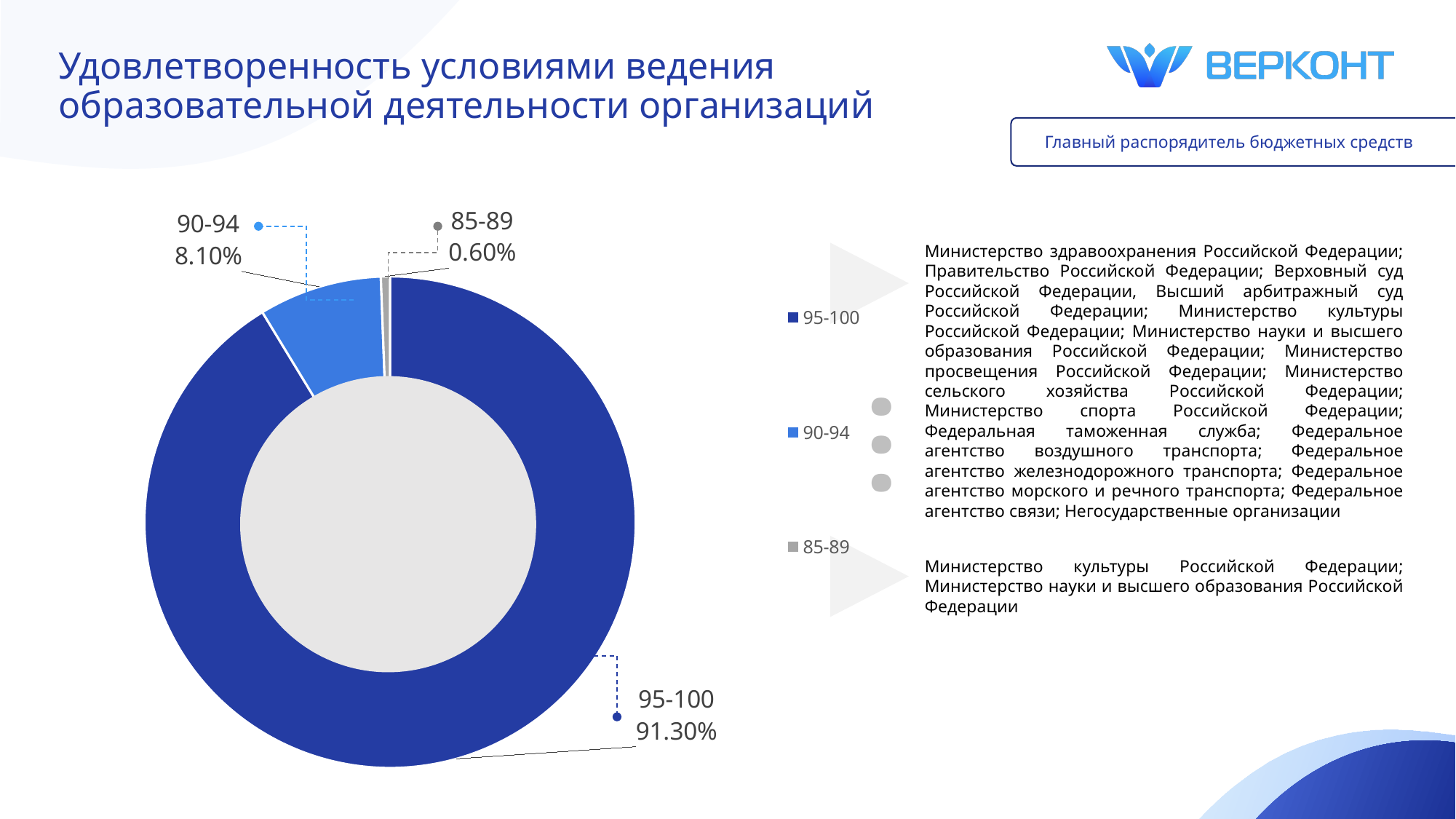
What is the difference in percentage points between the 95-100 and 90-94 categories? 83.20% How many entries does the chart legend list? 3 What is the value shown for the 85-89 category? 0.60% Which category has the largest share of the chart? 95-100 What type of chart is shown on the slide? Doughnut (pie) chart What is the difference in percentage points between the 90-94 and 85-89 categories? 7.50% Which category has the smallest share of the chart? 85-89 What is the value shown for the 90-94 category? 8.10% What share of the doughnut chart does the 95-100 category hold? 91.30% Which colour represents the 90-94 category in the chart? Light blue Which is larger, the share for 90-94 or the share for 85-89? 90-94 How many categories are shown in the chart? 3